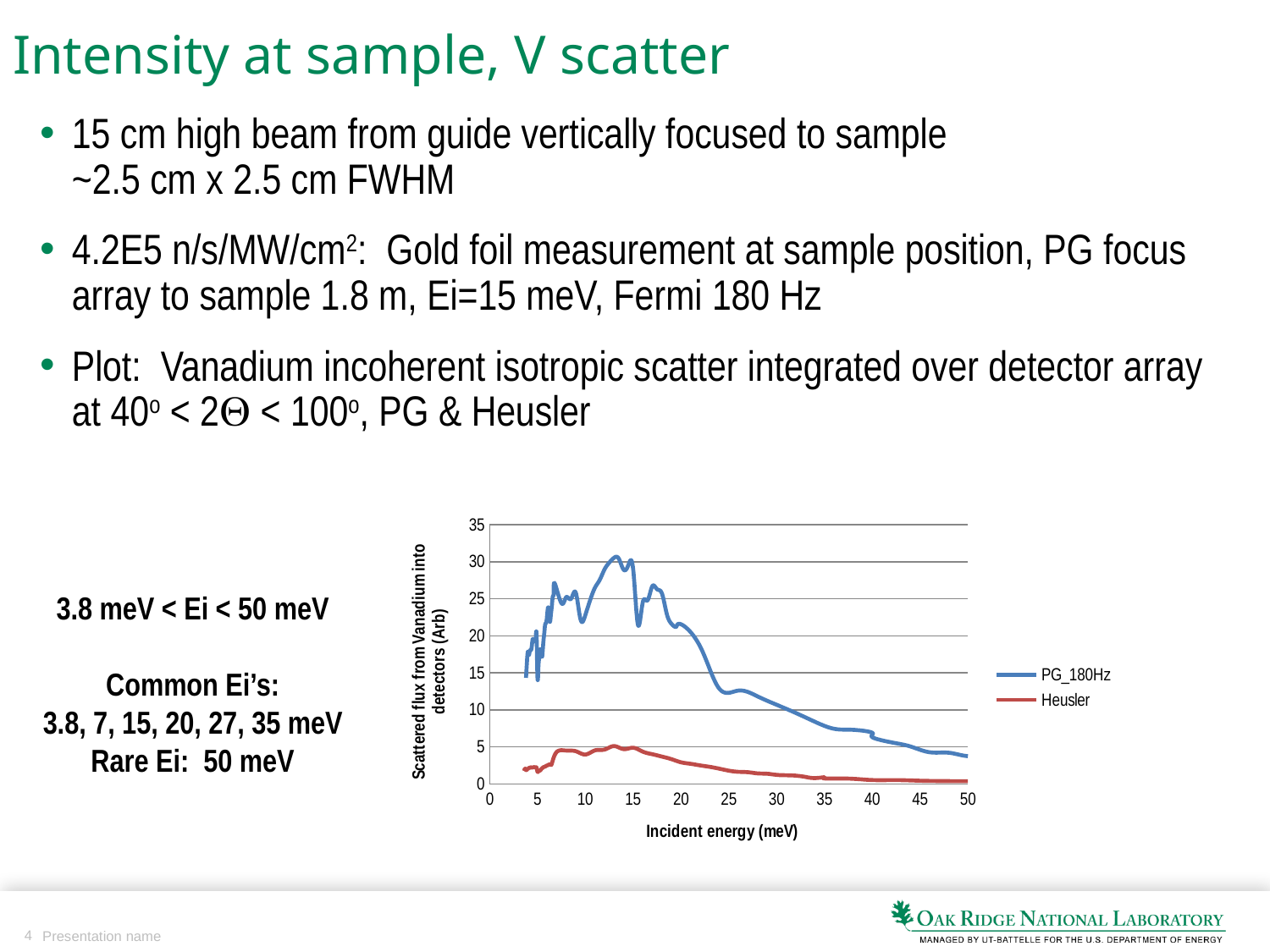
Is the PG_180Hz value at 15 meV greater or less than 25? greater Is the PG_180Hz value at 30 meV greater or less than 5? greater Is the Heusler value at 15 meV greater or less than 10? less Which series reaches the highest scattered flux anywhere on the chart? PG_180Hz Does the PG_180Hz series rise or fall as incident energy increases from 20 meV to 50 meV? fall Which series has the higher scattered flux at an incident energy of 15 meV, PG_180Hz or Heusler? PG_180Hz What is the x-axis title of the chart? Incident energy (meV) What are the two series named in the chart legend? PG_180Hz and Heusler How many series does the chart legend list? 2 What kind of chart is shown on the slide? line chart